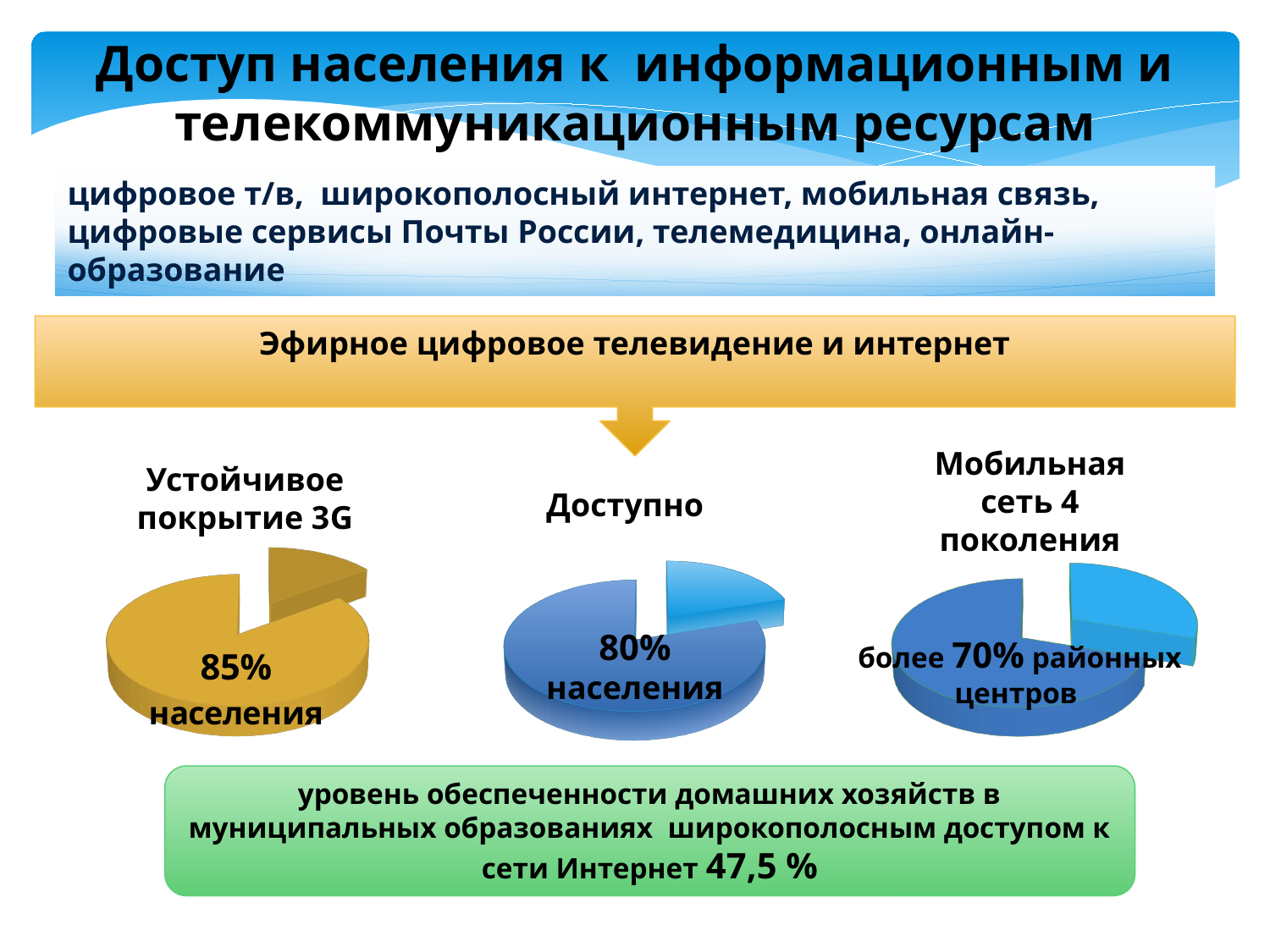
What colour is the "Устойчивое покрытие 3G" pie chart? gold/yellow What is the difference between the share printed on the "Устойчивое покрытие 3G" chart (85%) and the share printed on the "Доступно" chart (80%)? 5% Which is larger: the share printed on the "Устойчивое покрытие 3G" chart or the share printed on the "Доступно" chart? Устойчивое покрытие 3G What kind of chart is shown under the heading "Устойчивое покрытие 3G"? pie chart In the "Мобильная сеть 4 поколения" pie chart, what value is printed on the chart? более 70% районных центров How many slices does the "Доступно" pie chart have? 2 In the "Доступно" pie chart, what value is printed on the chart? 80% населения How many pie charts are shown on the slide? 3 In the "Устойчивое покрытие 3G" pie chart, what share of the population does the large slice represent? 85% In the "Устойчивое покрытие 3G" pie chart, what value is printed on the chart? 85% населения Which of the three pie charts shows the highest printed percentage? Устойчивое покрытие 3G What is the heading above the middle pie chart? Доступно